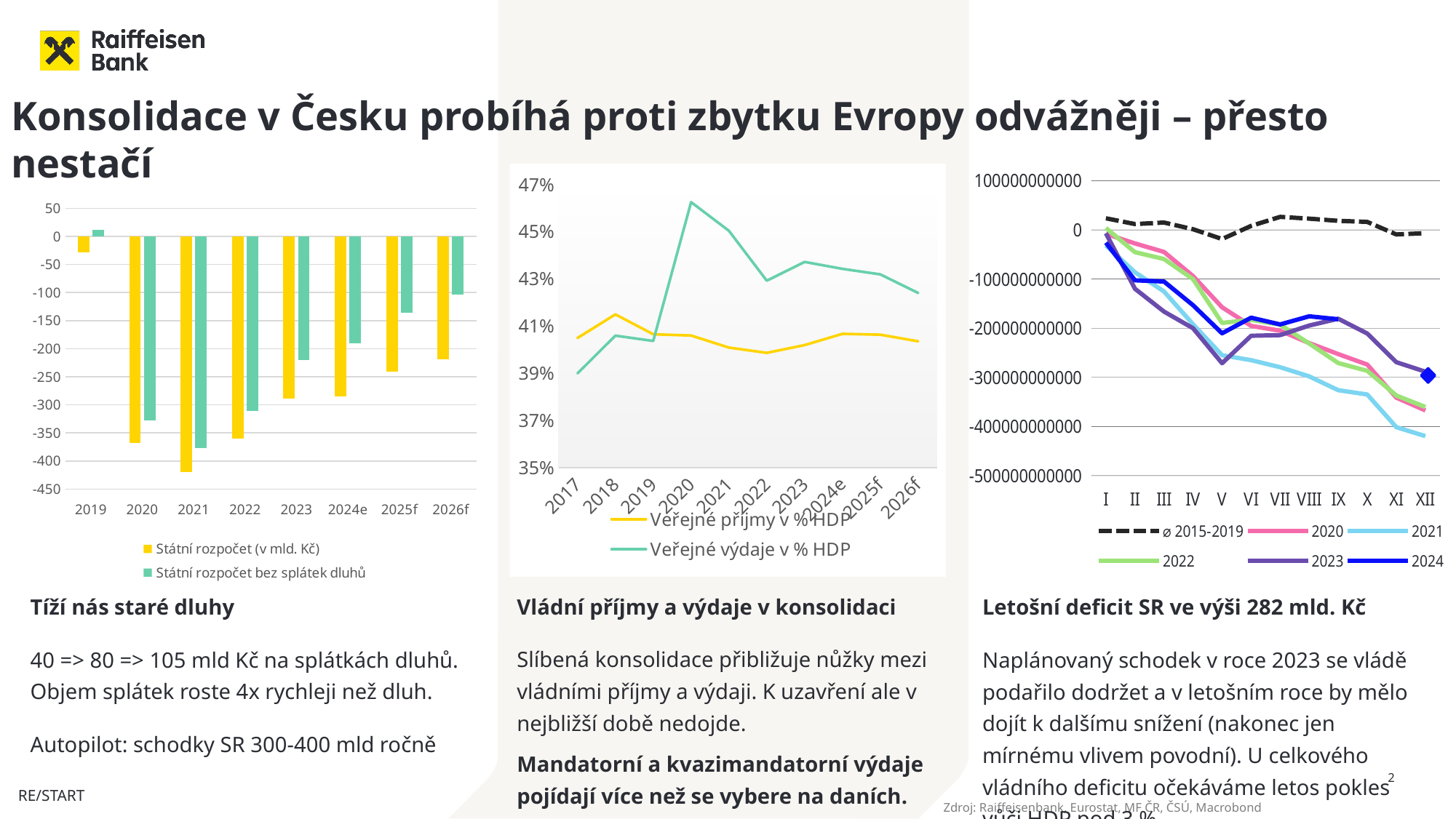
In the middle line chart, in which year does Veřejné výdaje v % HDP reach its highest value? 2020 In the right line chart, is the value for 2021 in month XII greater or less than -400000000000? less How many years are shown on the x axis of the left bar chart? 8 In the middle line chart, do the values for Veřejné výdaje v % HDP rise or fall from 2020 to 2026f? fall In the left bar chart, is the value for Státní rozpočet (v mld. Kč) in 2021 greater or less than -400? less In the middle line chart, is the value for Veřejné výdaje v % HDP in 2020 greater or less than 45%? greater In the left bar chart, which year has the lowest value for Státní rozpočet (v mld. Kč)? 2021 How many series does the legend of the left bar chart list? 2 What kind of chart is the left chart (Státní rozpočet)? bar chart In the right line chart, which series has the lowest value in month XII? 2021 How many series does the legend of the right line chart list? 6